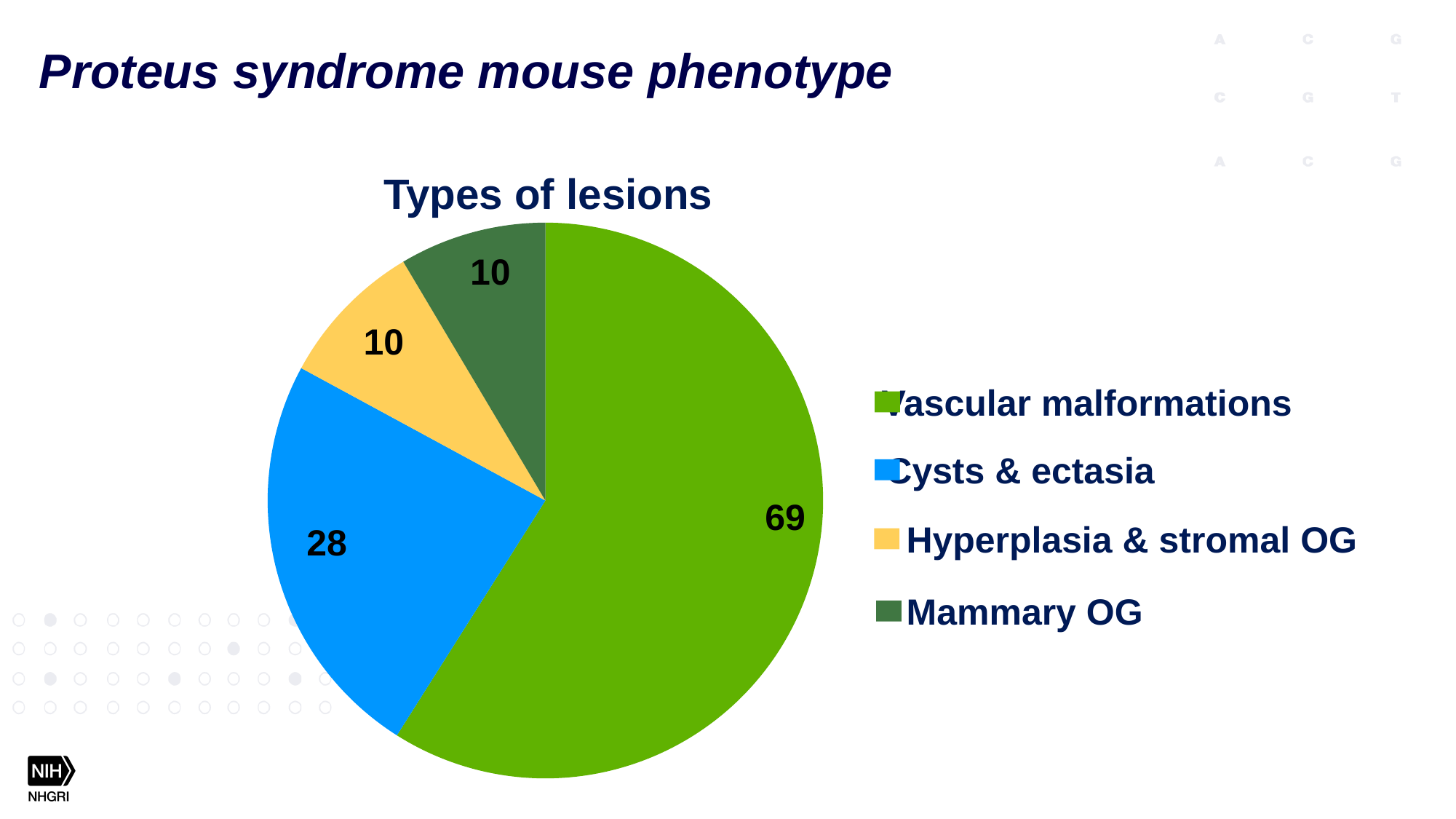
What is the title of the chart? Types of lesions What colour is the slice for Cysts & ectasia? Blue What is the total of all the values in the pie chart? 117 What is the value for Mammary OG? 10 What type of chart is shown on the slide? Pie chart What is the value for Cysts & ectasia? 28 How many lesion types are shown in the pie chart? 4 What is the value for Hyperplasia & stromal OG? 10 Which is larger, the value for Cysts & ectasia or the value for Mammary OG? Cysts & ectasia What is the difference between the values for Vascular malformations and Cysts & ectasia? 41 Which lesion type has the largest slice of the pie? Vascular malformations What is the value for Vascular malformations? 69